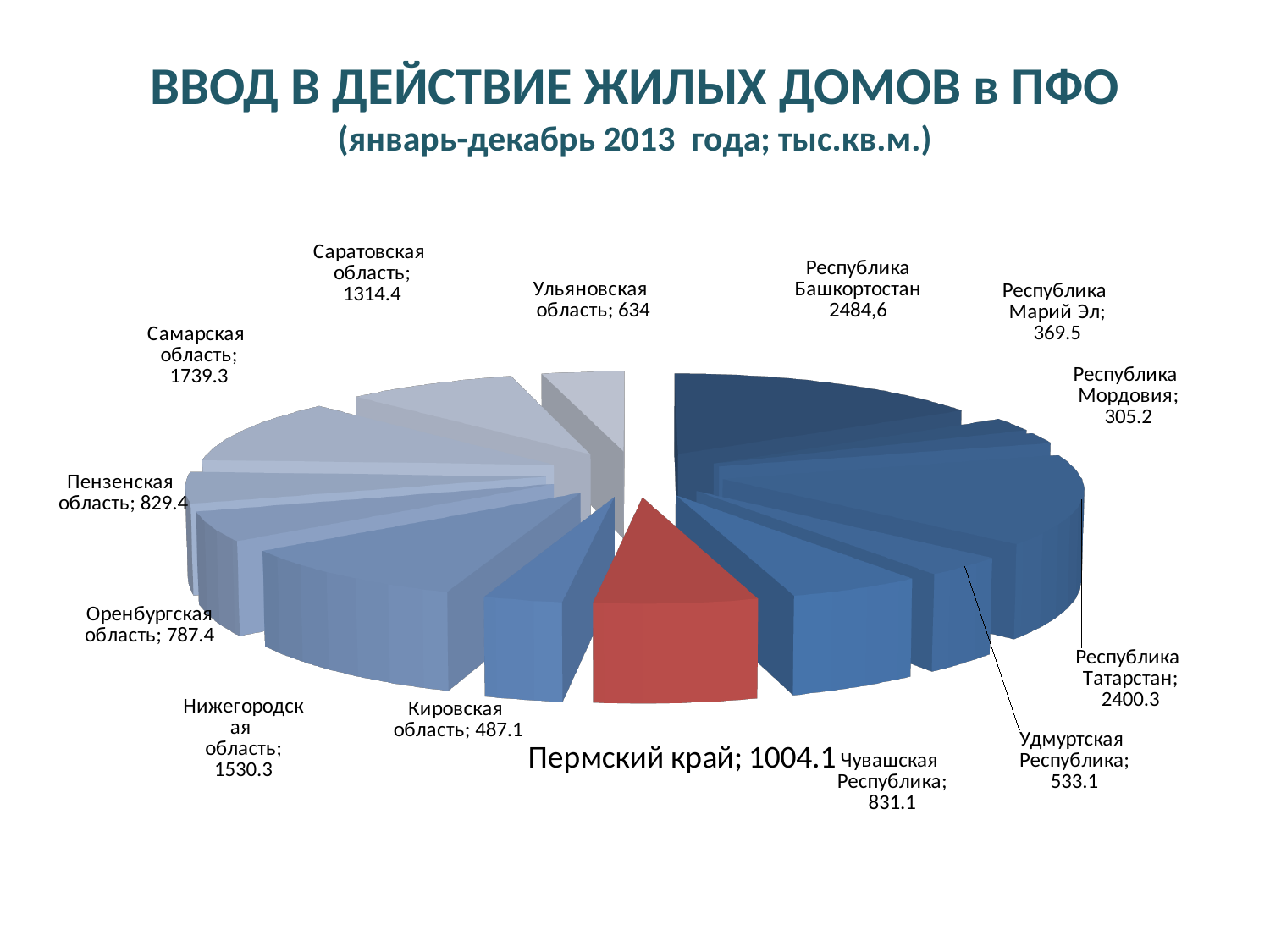
What is the value for Удмуртская Республика? 533.1 Which region has the smallest value in the pie chart? Республика Мордовия What kind of chart is shown on the slide? pie chart Which region has the largest value in the pie chart? Республика Башкортостан What is the value for Ульяновская область? 634 Which is larger, the value for Кировская область or the value for Оренбургская область? Оренбургская область What is the value for Пермский край? 1004.1 Which region's slice is coloured red in the pie chart? Пермский край What is the value for Республика Башкортостан? 2484,6 How many regions (slices) are shown in the pie chart? 14 What is the difference between the values for Нижегородская область and Пермский край? 526.2 What is the difference between the values for Самарская область and Саратовская область? 424.9